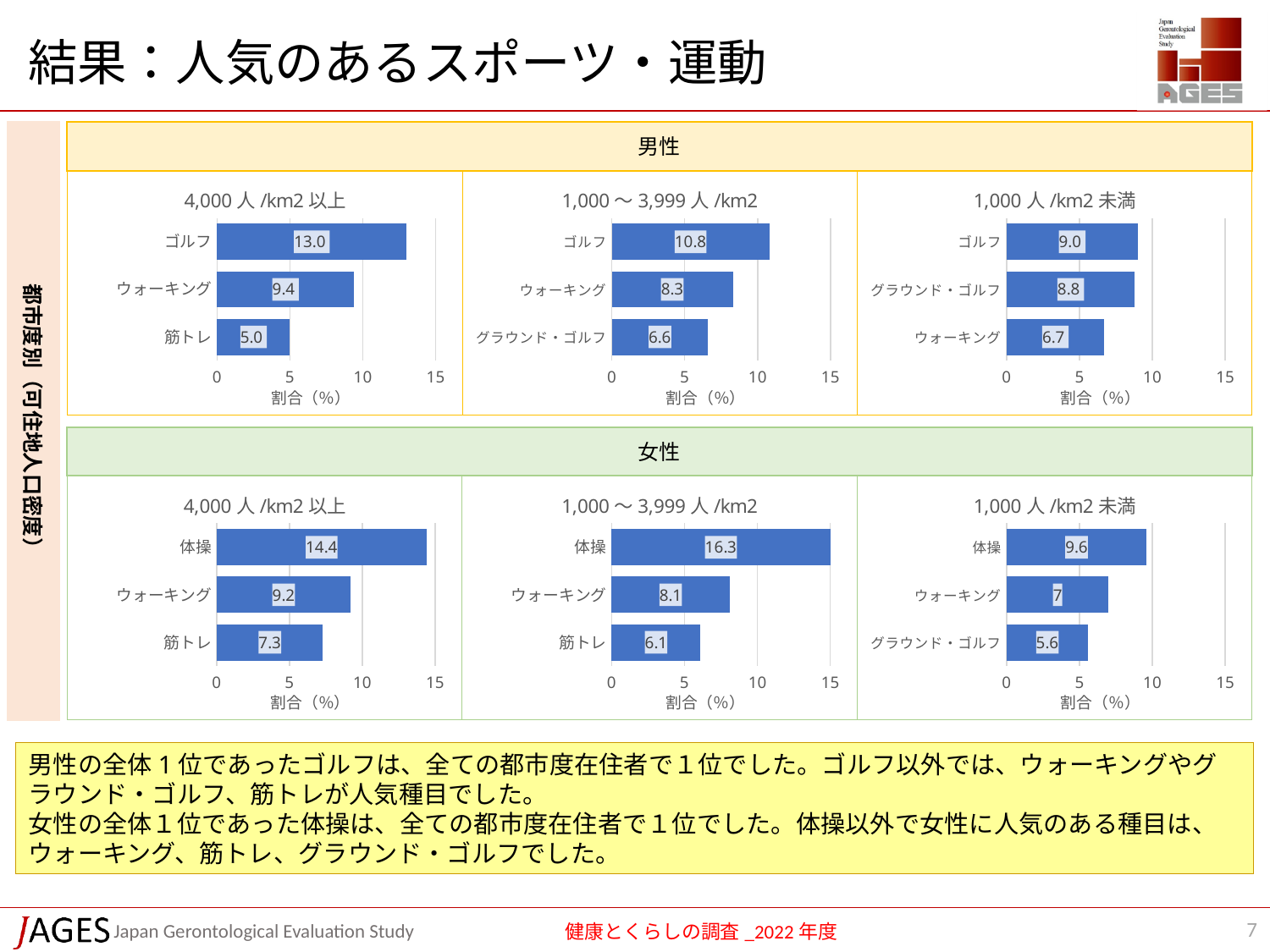
In the 男性 4,000人/km2以上 chart, what is the difference between ゴルフ and 筋トレ? 8.0 How many categories are shown in the 男性 4,000人/km2以上 chart? 3 In the 女性 1,000人/km2未満 chart, is the value for 体操 greater or less than 5? greater In the 男性 1,000〜3,999人/km2 chart, what is the value for グラウンド・ゴルフ? 6.6 In the 男性 1,000人/km2未満 chart, which category has the lowest value? ウォーキング In the 男性 1,000〜3,999人/km2 chart, which is larger, ゴルフ or ウォーキング? ゴルフ What kind of chart is the 女性 4,000人/km2以上 chart? bar chart In the 男性 4,000人/km2以上 chart, what is the value for ゴルフ? 13.0 In the 女性 1,000〜3,999人/km2 chart, what is the difference between ウォーキング and 筋トレ? 2.0 In the 女性 1,000〜3,999人/km2 chart, what is the value for 体操? 16.3 In the 女性 1,000人/km2未満 chart, what is the value for ウォーキング? 7 In the 女性 4,000人/km2以上 chart, which category has the highest value? 体操